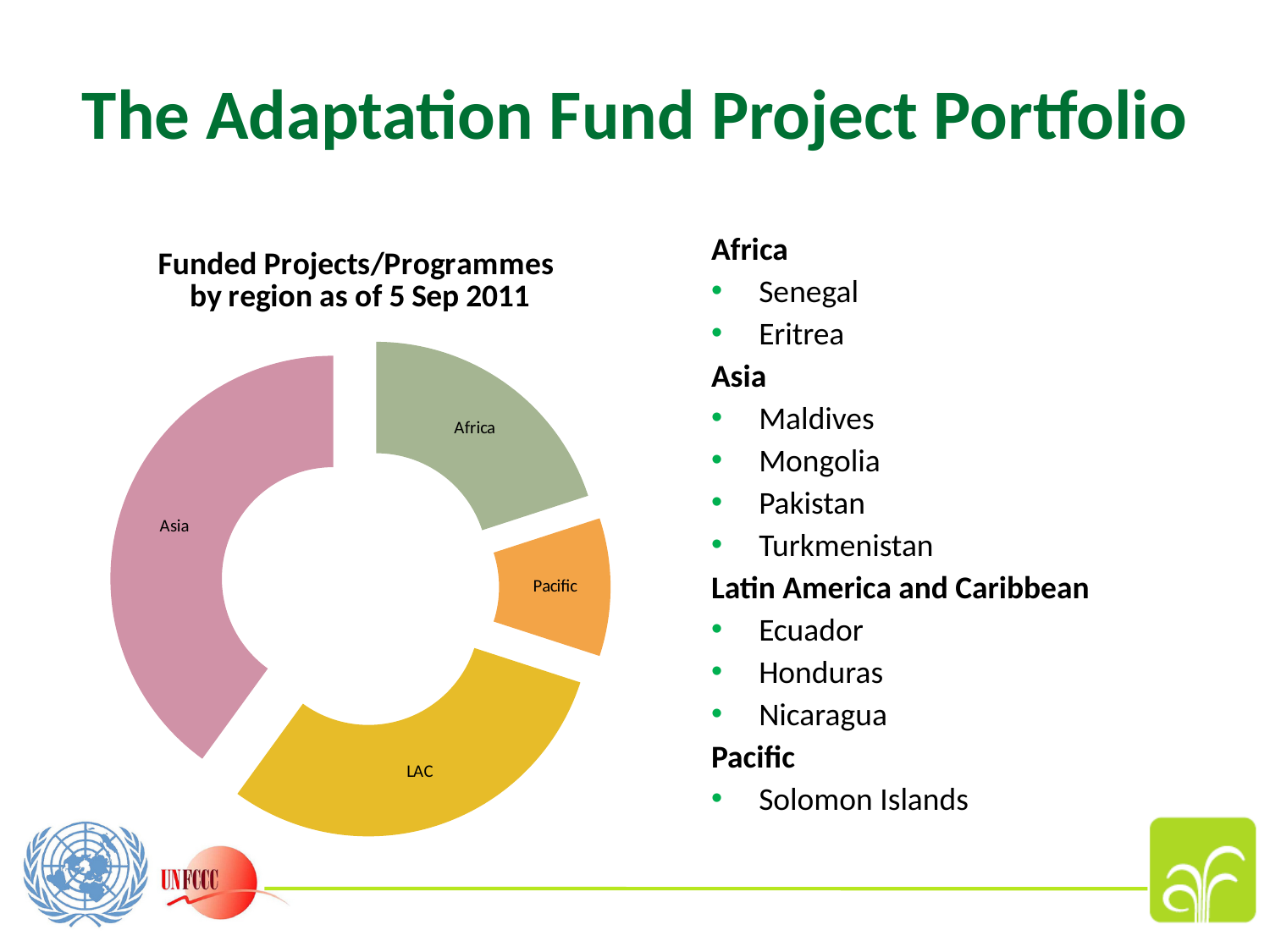
How many regions (slices) does the chart show? 4 Which region's slice is coloured yellow? LAC Which region has the largest slice in the chart? Asia What colour is the Asia slice in the chart? pink What kind of chart is shown on the slide? doughnut chart What is the title of the chart? Funded Projects/Programmes by region as of 5 Sep 2011 Which slice is larger, Africa or Pacific? Africa Which slice is larger, Asia or LAC? Asia Which slice is larger, LAC or Africa? LAC Which region has the smallest slice in the chart? Pacific